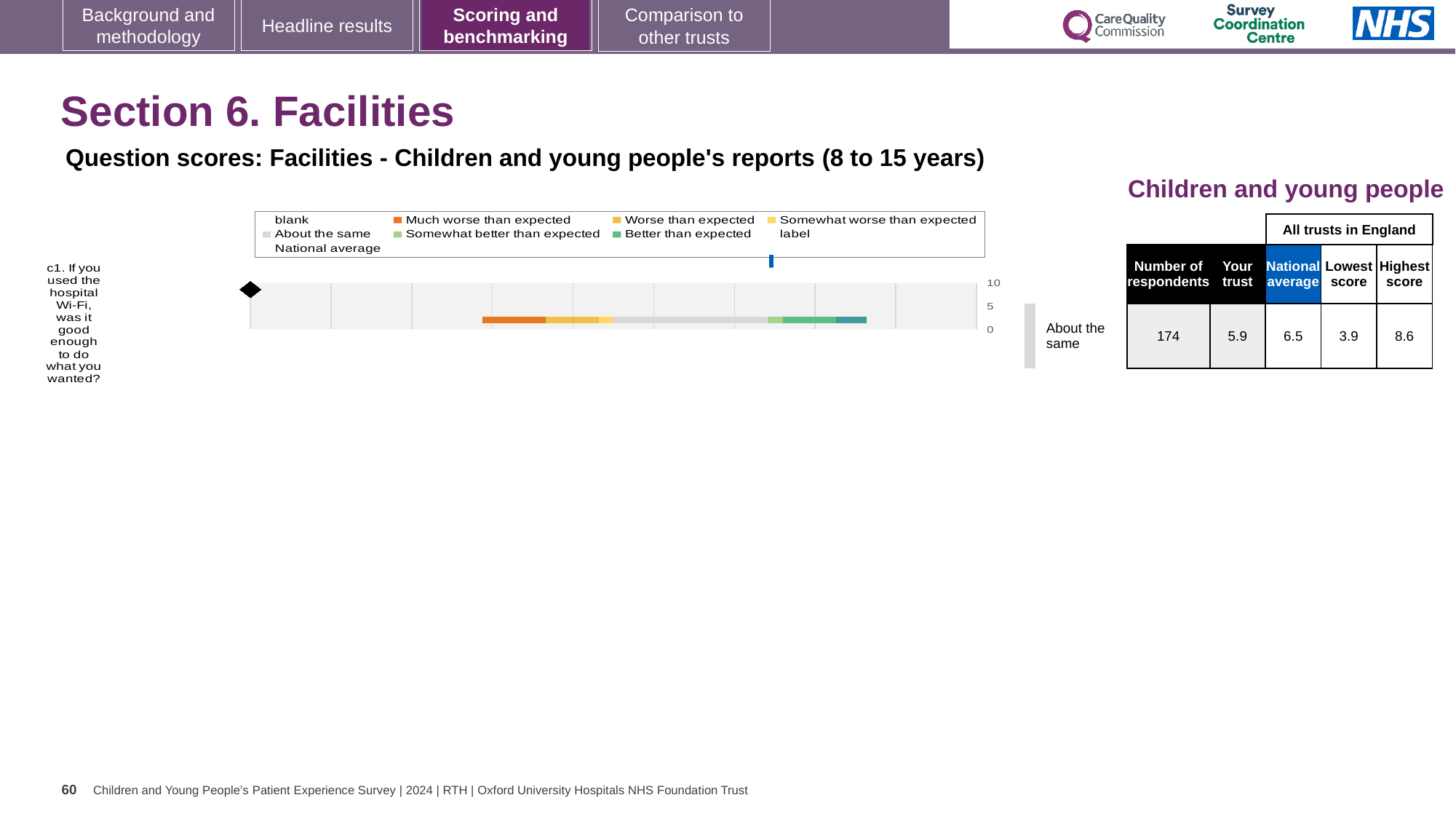
What kind of chart is shown on the slide? bar chart What is the difference between the national average and the 'Your trust' score for question c1? 0.6 How many survey questions are plotted in the chart? 1 Which is larger for question c1: the 'Your trust' score or the national average? National average What is the 'Your trust' score for question c1 about the hospital Wi-Fi? 5.9 How many respondents answered question c1 about the hospital Wi-Fi? 174 What benchmark category is given for question c1 about the hospital Wi-Fi? About the same What is the difference between the highest score and the lowest score for question c1? 4.7 What is the highest score among all trusts in England for question c1? 8.6 What is the national average score for question c1 about the hospital Wi-Fi? 6.5 What is the maximum value shown on the chart's score axis? 10 What is the lowest score among all trusts in England for question c1? 3.9